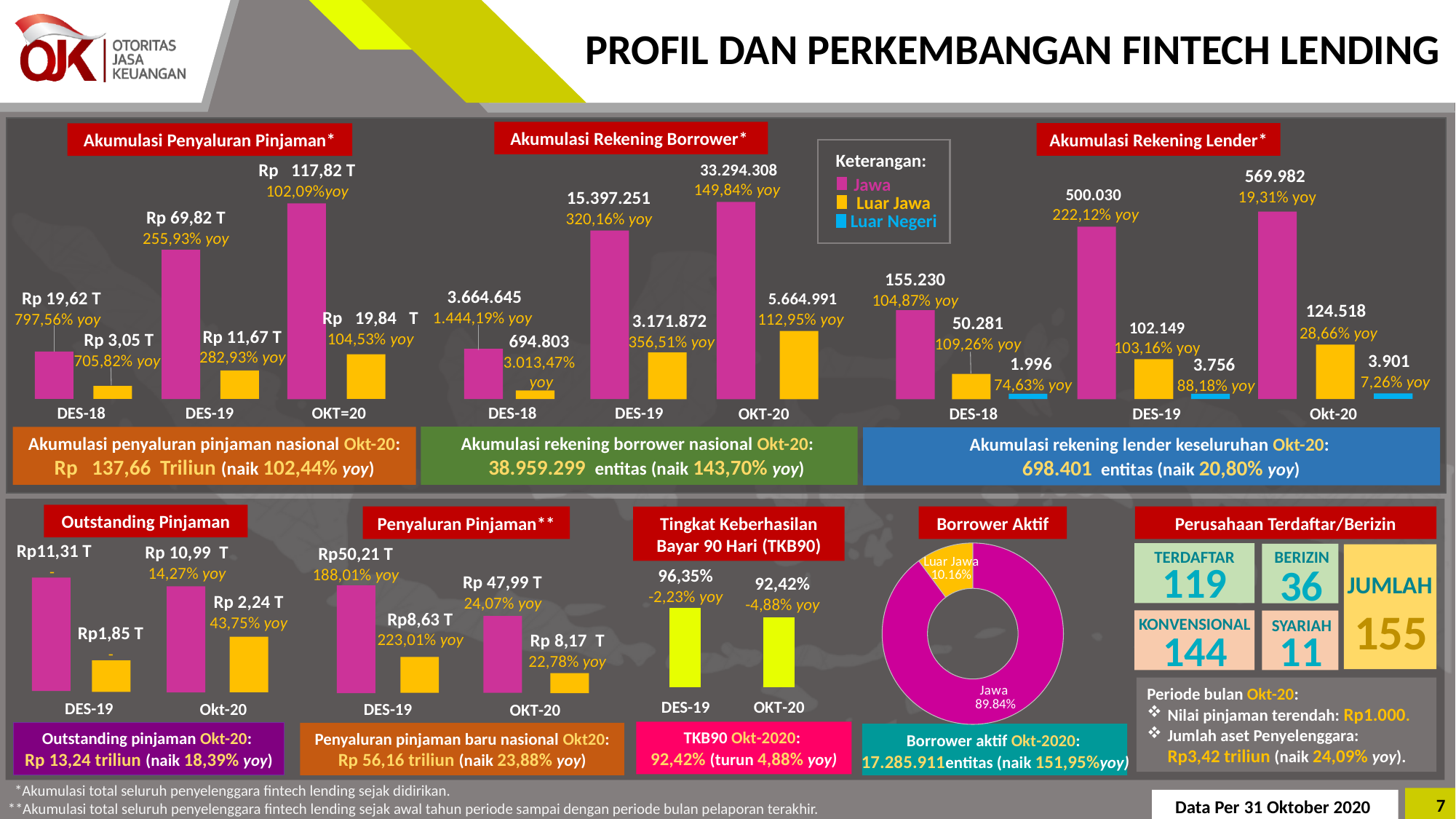
In the 'Akumulasi Penyaluran Pinjaman' chart, what is the value for Luar Jawa in DES-18? Rp 3,05 T In the 'Akumulasi Rekening Borrower' chart, what is the value for Jawa in DES-19? 15.397.251 What kind of chart is the 'Borrower Aktif' chart? doughnut chart In the 'Akumulasi Penyaluran Pinjaman' chart, what is the value for Jawa in OKT-20? Rp 117,82 T In the 'Borrower Aktif' chart, what share of the pie is Luar Jawa? 10.16% In the 'Akumulasi Rekening Lender' chart, what is the value for Luar Negeri in Okt-20? 3.901 In the 'Outstanding Pinjaman' chart, what is the difference between the Jawa values for DES-19 and Okt-20? Rp 0,32 T How many series does the 'Keterangan' legend list? 3 In the 'Tingkat Keberhasilan Bayar 90 Hari (TKB90)' chart, do the values rise or fall from DES-19 to OKT-20? fall In the 'Akumulasi Rekening Borrower' chart, which period has the highest Jawa value? OKT-20 In the 'Penyaluran Pinjaman' chart, which is larger: Luar Jawa in DES-19 or Luar Jawa in OKT-20? DES-19 In the 'Akumulasi Rekening Lender' chart, which period has the lowest Luar Jawa value? DES-18